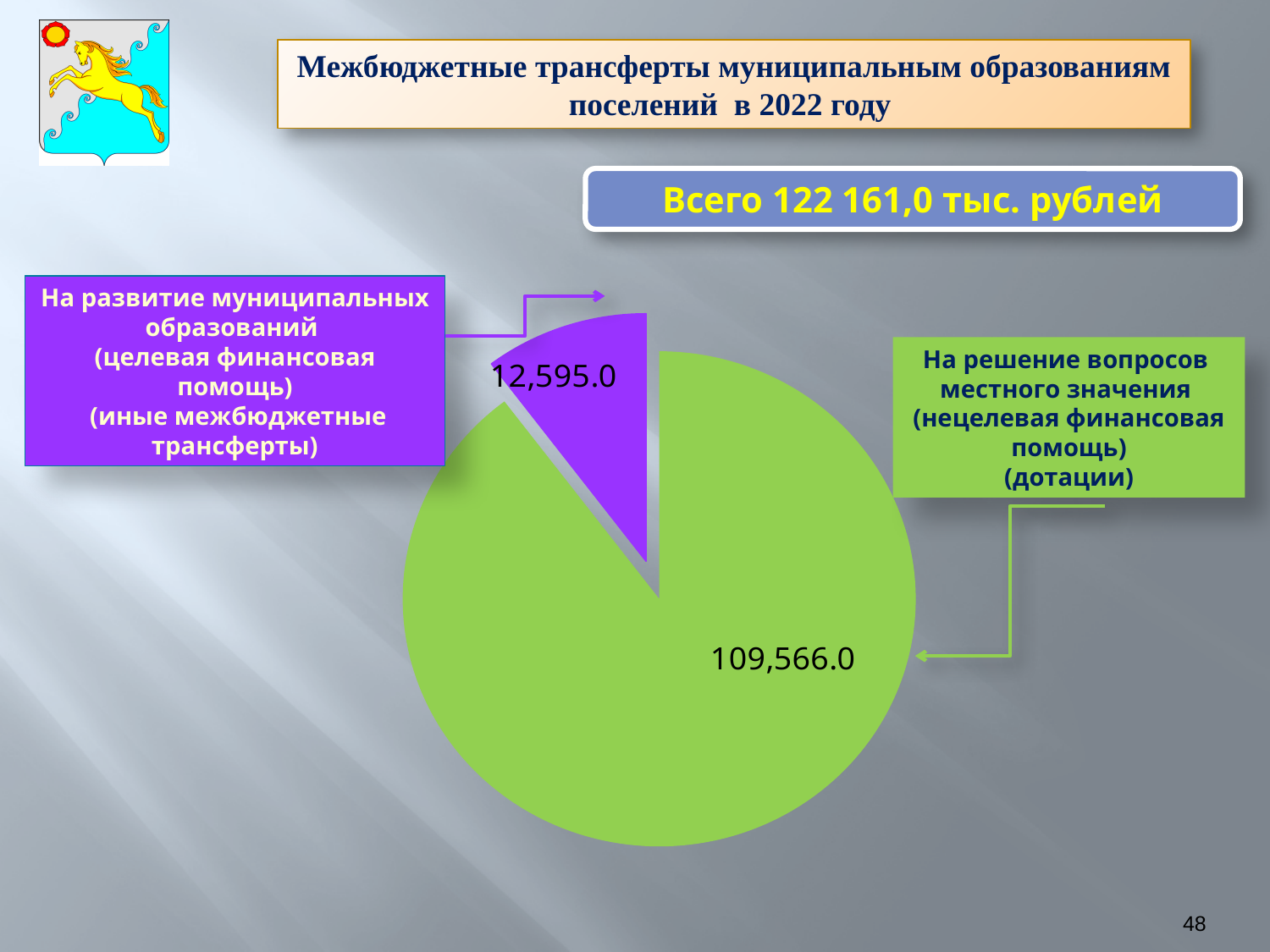
What type of chart is shown on the slide? Pie chart Which is larger: the slice for дотации or the slice for иные межбюджетные трансферты? дотации What colour is the slice for 'На решение вопросов местного значения (дотации)'? Green What is the value of the slice for 'На развитие муниципальных образований (целевая финансовая помощь) (иные межбюджетные трансферты)'? 12,595.0 What is the difference between the value for дотации (109,566.0) and the value for иные межбюджетные трансферты (12,595.0)? 96,971.0 Which category has the largest slice of the pie? На решение вопросов местного значения (нецелевая финансовая помощь) (дотации) How many slices does the pie chart have? 2 Is the value for иные межбюджетные трансферты greater or less than 100,000? less Which category has the smallest slice of the pie? На развитие муниципальных образований (целевая финансовая помощь) (иные межбюджетные трансферты) What is the total of all intergovernmental transfers shown on the slide? 122 161,0 тыс. рублей What is the value of the slice for 'На решение вопросов местного значения (нецелевая финансовая помощь) (дотации)'? 109,566.0 What colour is the slice for 'На развитие муниципальных образований (иные межбюджетные трансферты)'? Purple